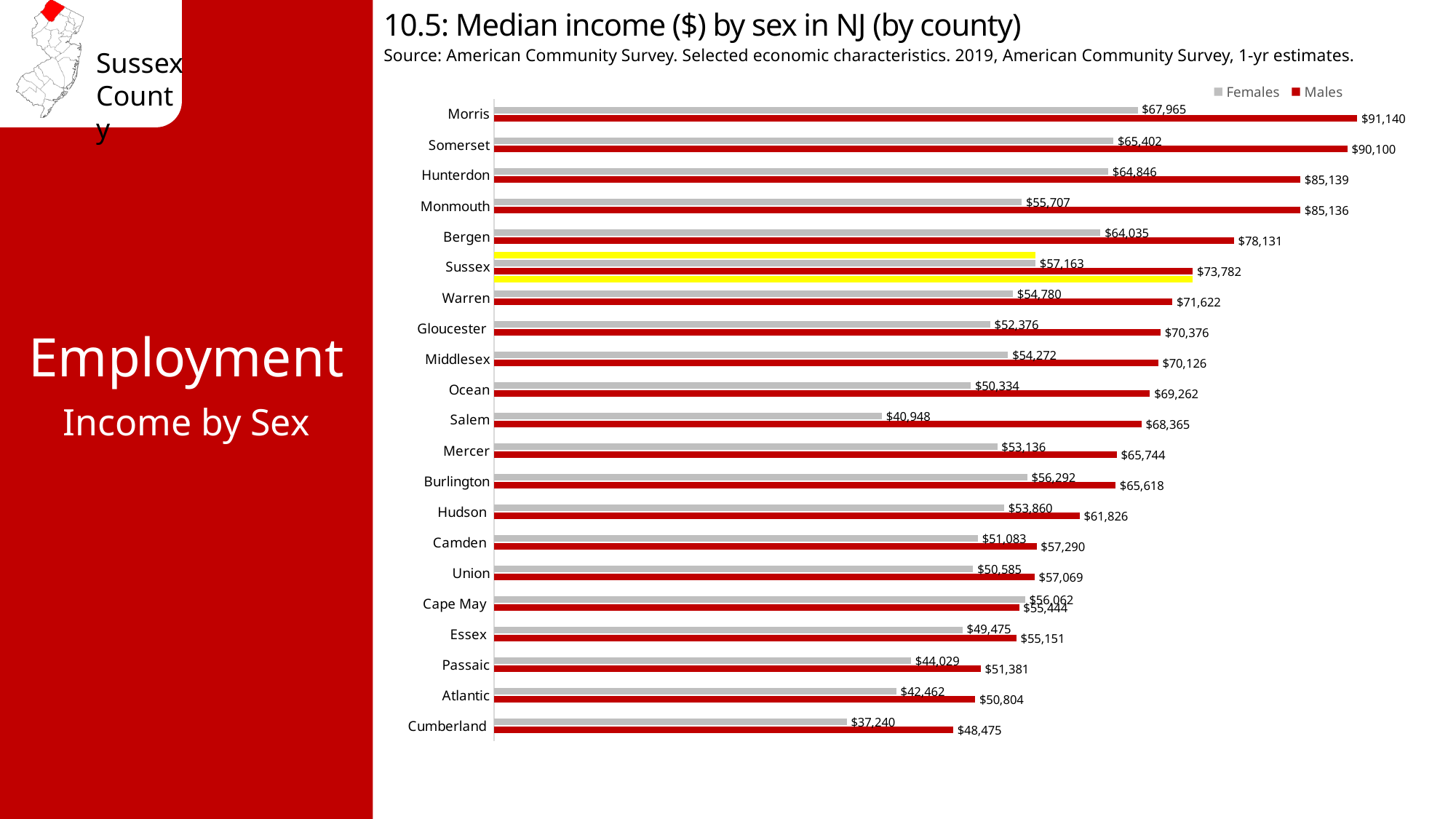
In Cape May County, is the median income higher for females or for males? Females What kind of chart is shown on the slide? Bar chart What is the median income for females in Sussex County? $57,163 How many series does the legend list? 2 Which county has the lowest median income for females? Cumberland Which county has the highest median income for males? Morris What is the median income for males in Sussex County? $73,782 How many counties are shown in the chart? 21 What is the median income for females in Salem County? $40,948 What is the difference between male and female median income in Morris County? $23,175 Which county's bars are highlighted in yellow on the chart? Sussex What is the difference between male and female median income in Sussex County? $16,619